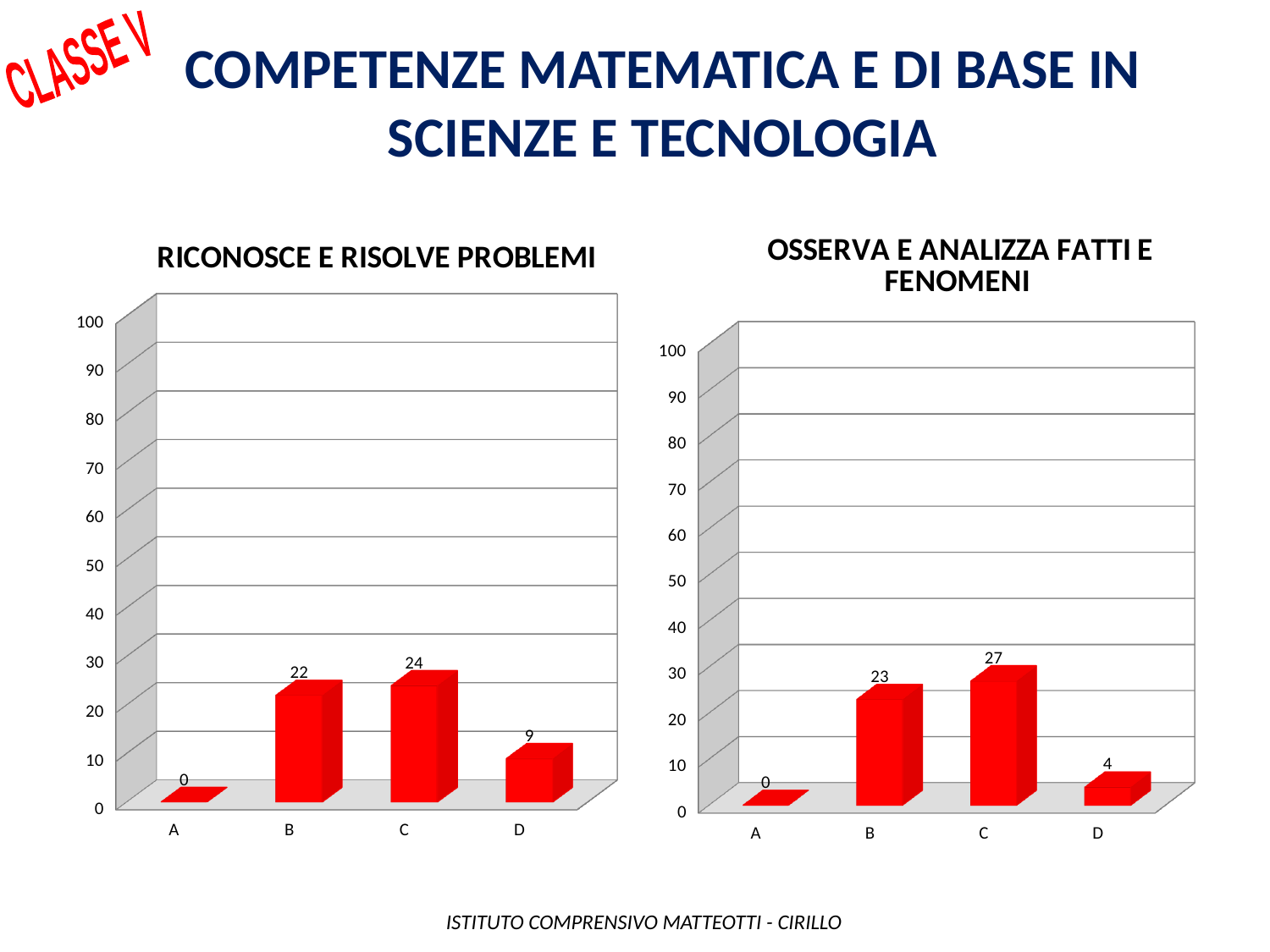
In the 'OSSERVA E ANALIZZA FATTI E FENOMENI' chart, which category has the lowest value? A In the 'RICONOSCE E RISOLVE PROBLEMI' chart, which category has the highest value? C What kind of chart is the 'RICONOSCE E RISOLVE PROBLEMI' chart? Bar chart In the 'RICONOSCE E RISOLVE PROBLEMI' chart, what is the value for category D? 9 In the 'OSSERVA E ANALIZZA FATTI E FENOMENI' chart, what is the value for category A? 0 How many categories are shown in the 'OSSERVA E ANALIZZA FATTI E FENOMENI' chart? 4 In the 'OSSERVA E ANALIZZA FATTI E FENOMENI' chart, which is larger, the value for B or the value for D? B In the 'OSSERVA E ANALIZZA FATTI E FENOMENI' chart, what is the difference between the values for B and D? 19 In the 'OSSERVA E ANALIZZA FATTI E FENOMENI' chart, what is the value for category C? 27 In the 'RICONOSCE E RISOLVE PROBLEMI' chart, what is the value for category B? 22 In the 'RICONOSCE E RISOLVE PROBLEMI' chart, is the value for C greater or less than 50? less In the 'RICONOSCE E RISOLVE PROBLEMI' chart, what is the difference between the values for C and B? 2